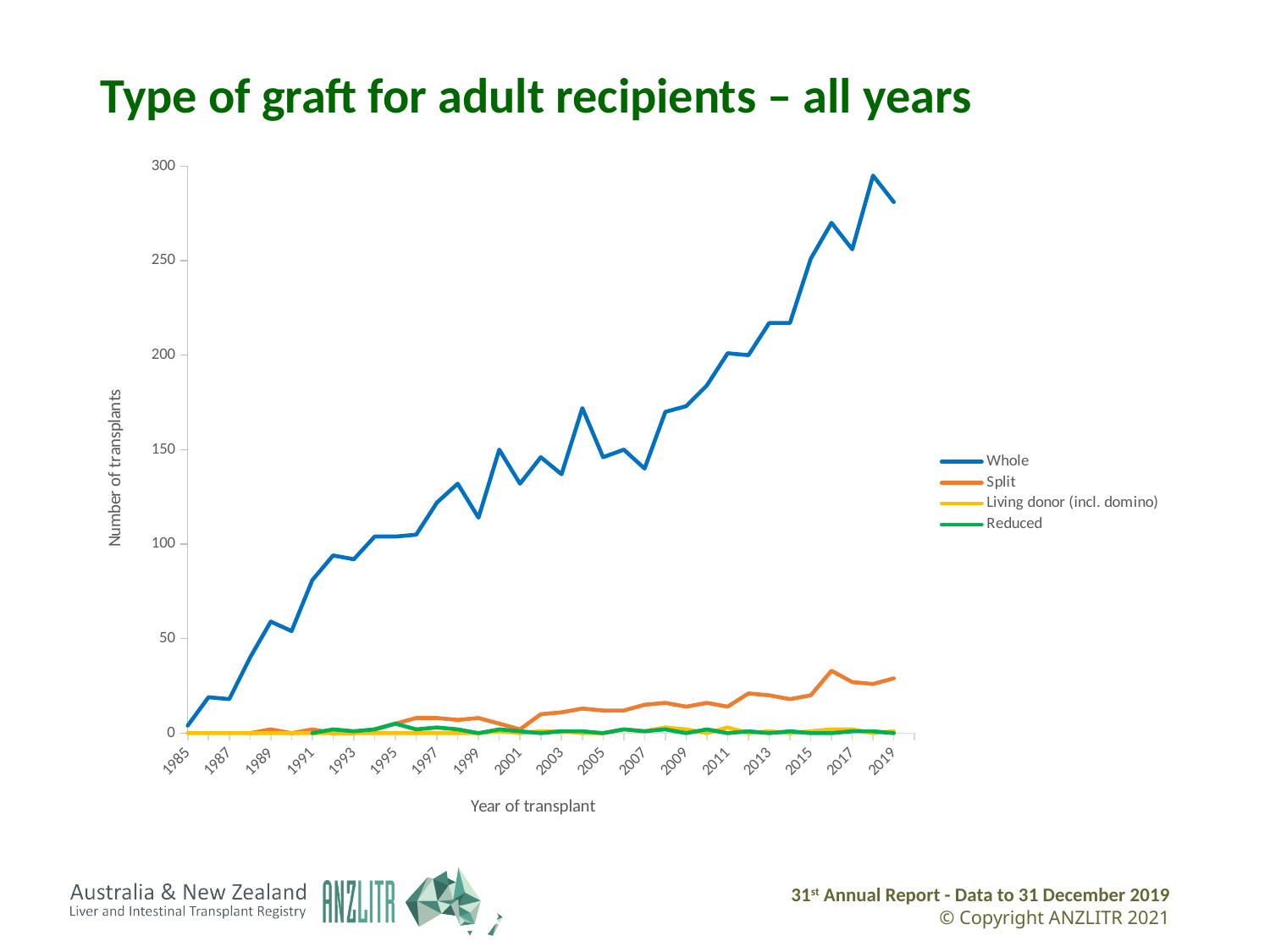
Does the number of Whole graft transplants generally rise or fall from 1985 to 2019? rise How many year labels are shown on the x axis? 18 What is the title of the chart? Type of graft for adult recipients – all years Is the value for Whole in 2013 greater or less than 200? greater Is the value for Whole in 1985 greater or less than 50? less Is the value for Split in 2019 greater or less than 50? less In 2019, which series has the larger value, Whole or Split? Whole Which series has the highest number of transplants across the years? Whole What kind of chart is shown on the slide? line chart How many series does the legend list? 4 Which series is plotted with the blue line? Whole